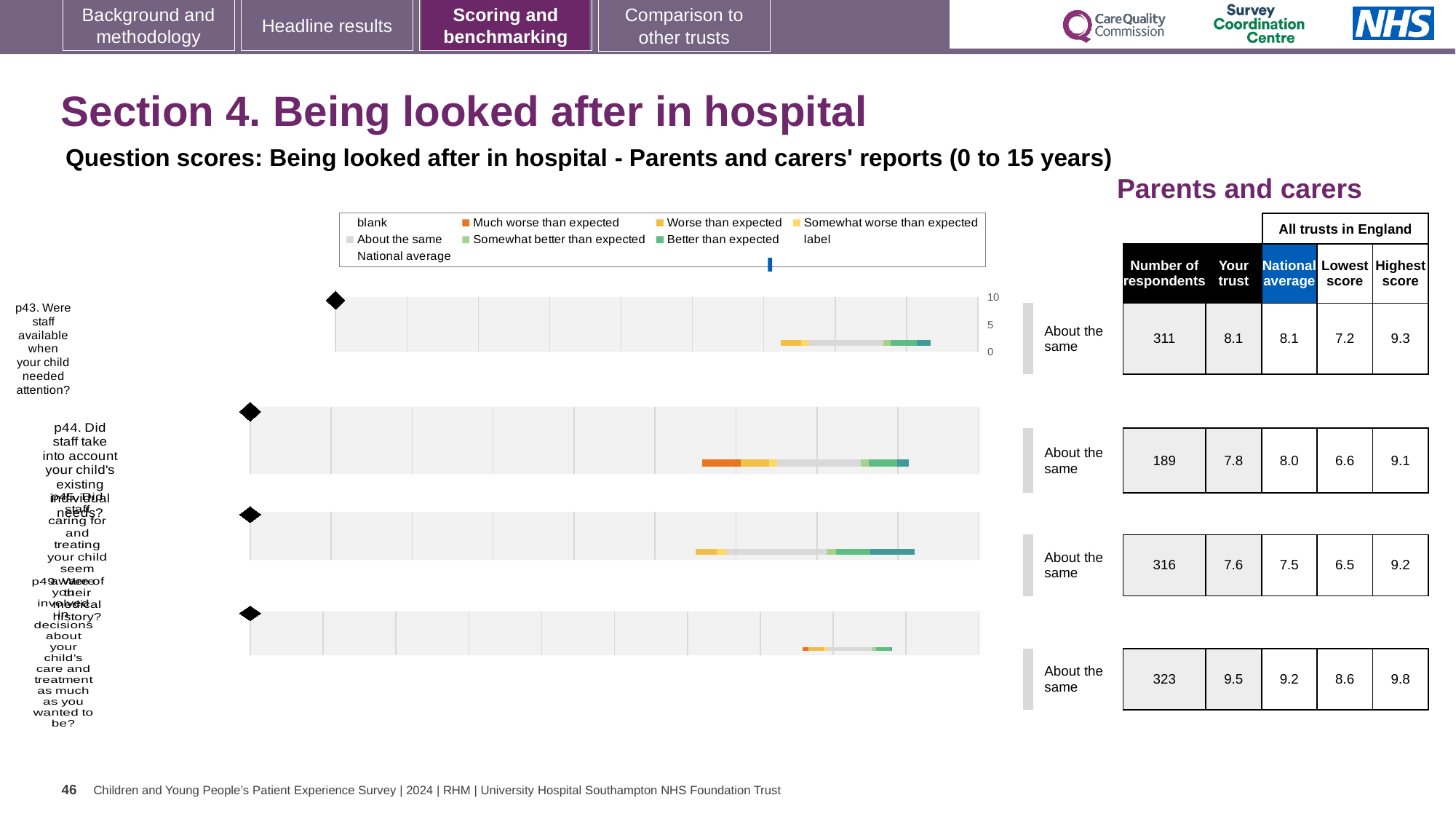
For question p44, what is the difference between the national average and the 'Your trust' score? 0.2 What is the 'Your trust' score for question p43? 8.1 What is the national average score for question p44 (Did staff take into account your child's existing individual needs?)? 8.0 How many respondents are shown for question p43 (Were staff available when your child needed attention?)? 311 What kind of chart is used to show each question's benchmark on this slide? Bar chart What is the highest 'Your trust' score shown in the table on this slide? 9.5 What is the lowest 'Your trust' score shown in the table on this slide? 7.6 How many question rows (charts) are shown on this slide? 4 What is the highest score across all trusts in England for the third question row (p45)? 9.2 What benchmark category is shown for question p43 next to its chart? About the same What is the lowest score across all trusts in England for question p44? 6.6 Which has the larger 'Your trust' score, question p43 or question p44? p43